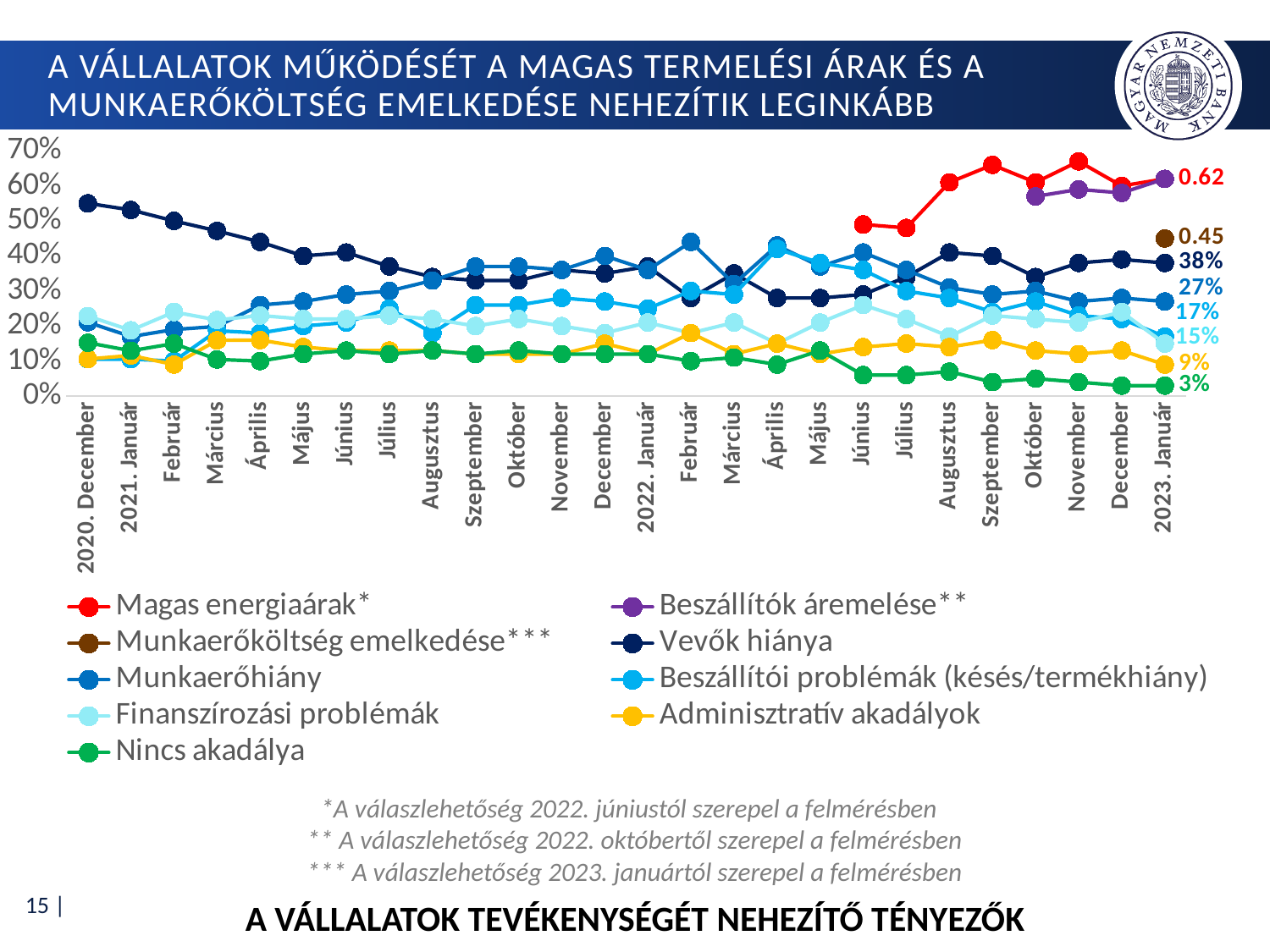
What is the value for Munkaerőhiány in 2023. Január? 27% How many series does the legend list? 9 What kind of chart is shown on the slide? line chart How many months (points) are shown along the x axis? 26 What value is labelled for Munkaerőköltség emelkedése in 2023. Január? 0.45 In 2023. Január, how much higher is Vevők hiánya than Munkaerőhiány? 11 percentage points In 2023. Január, which is larger: Beszállítói problémák (késés/termékhiány) or Finanszírozási problémák? Beszállítói problémák (késés/termékhiány) Is the value for Vevők hiánya in 2020. December greater or less than 50%? greater What is the value for Nincs akadálya in 2023. Január? 3% Which series has the lowest value in 2023. Január? Nincs akadálya What value is labelled for Magas energiaárak at the end of the series (2023. Január)? 0.62 What is the value for Vevők hiánya in 2023. Január? 38%